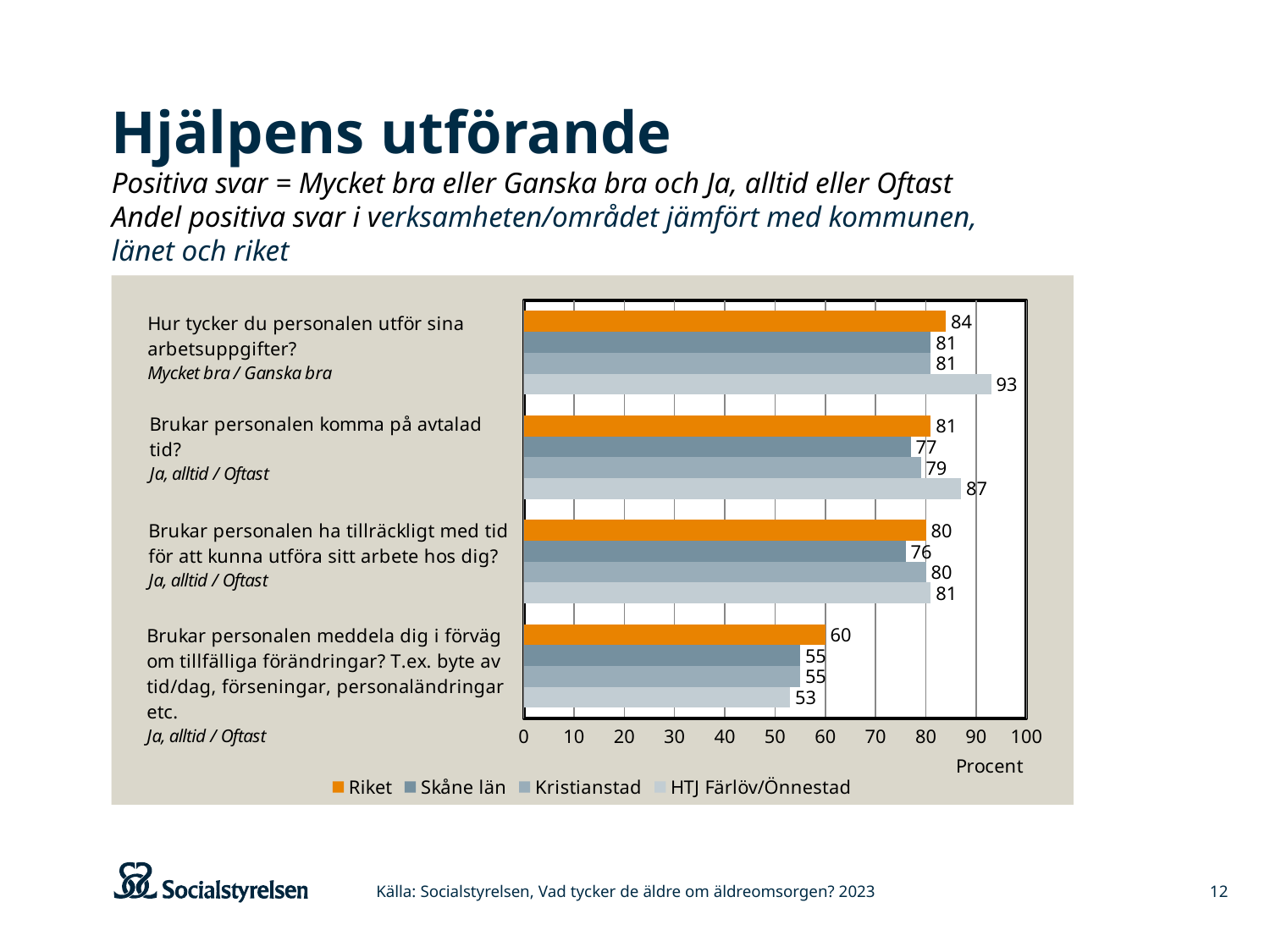
What is the value for HTJ Färlöv/Önnestad on 'Brukar personalen meddela dig i förväg om tillfälliga förändringar?' 53 What kind of chart is shown on the slide? bar chart What is the value for HTJ Färlöv/Önnestad on 'Hur tycker du personalen utför sina arbetsuppgifter?' 93 Which series has the highest value on 'Brukar personalen komma på avtalad tid?' HTJ Färlöv/Önnestad Which series has the lowest value on 'Brukar personalen meddela dig i förväg om tillfälliga förändringar?' HTJ Färlöv/Önnestad What is the label on the horizontal axis of the chart? Procent Which is larger on 'Brukar personalen komma på avtalad tid?': Kristianstad or Skåne län? Kristianstad What is the value for Skåne län on 'Brukar personalen ha tillräckligt med tid för att kunna utföra sitt arbete hos dig?' 76 How many questions (categories) are plotted in the chart? 4 What is the difference between HTJ Färlöv/Önnestad and Riket on 'Hur tycker du personalen utför sina arbetsuppgifter?' 9 How many series does the legend list? 4 What is the value for Riket on 'Brukar personalen komma på avtalad tid?' 81